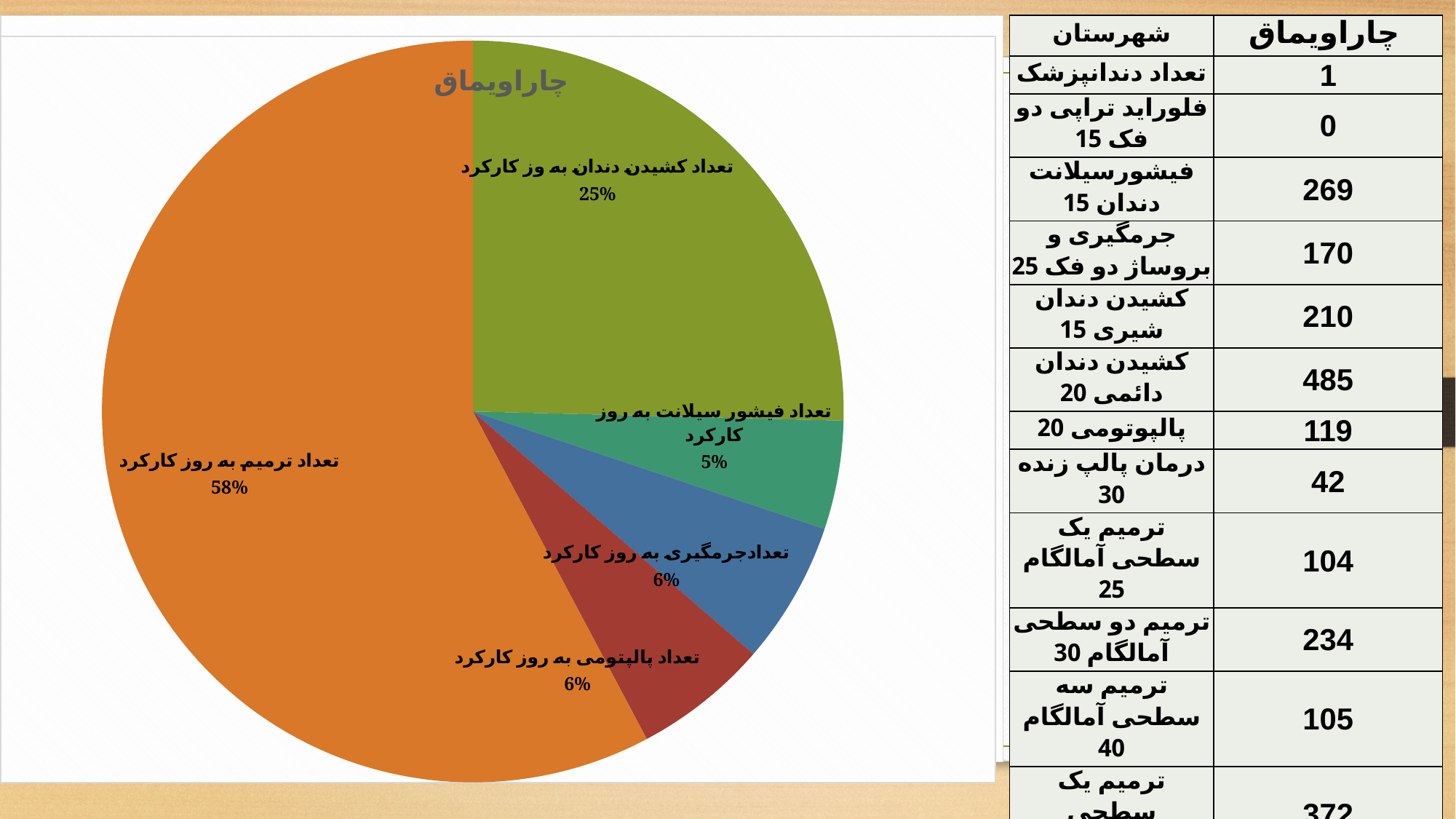
What share of the pie does تعداد پالپتومی به روز کارکرد have? 6% Which is larger, the share for تعداد کشیدن دندان به روز کارکرد or the share for تعداد جرمگیری به روز کارکرد? تعداد کشیدن دندان به روز کارکرد What is the difference in percentage points between تعداد ترمیم به روز کارکرد and تعداد کشیدن دندان به روز کارکرد? 33 What share of the pie does تعداد کشیدن دندان به روز کارکرد have? 25% Which slice of the pie chart is the smallest? تعداد فیشور سیلانت به روز کارکرد What is the title of the pie chart? چاراویماق What share of the pie does تعداد جرمگیری به روز کارکرد have? 6% Which slice of the pie chart is the largest? تعداد ترمیم به روز کارکرد What kind of chart is shown on the slide? pie chart How many slices does the pie chart have? 5